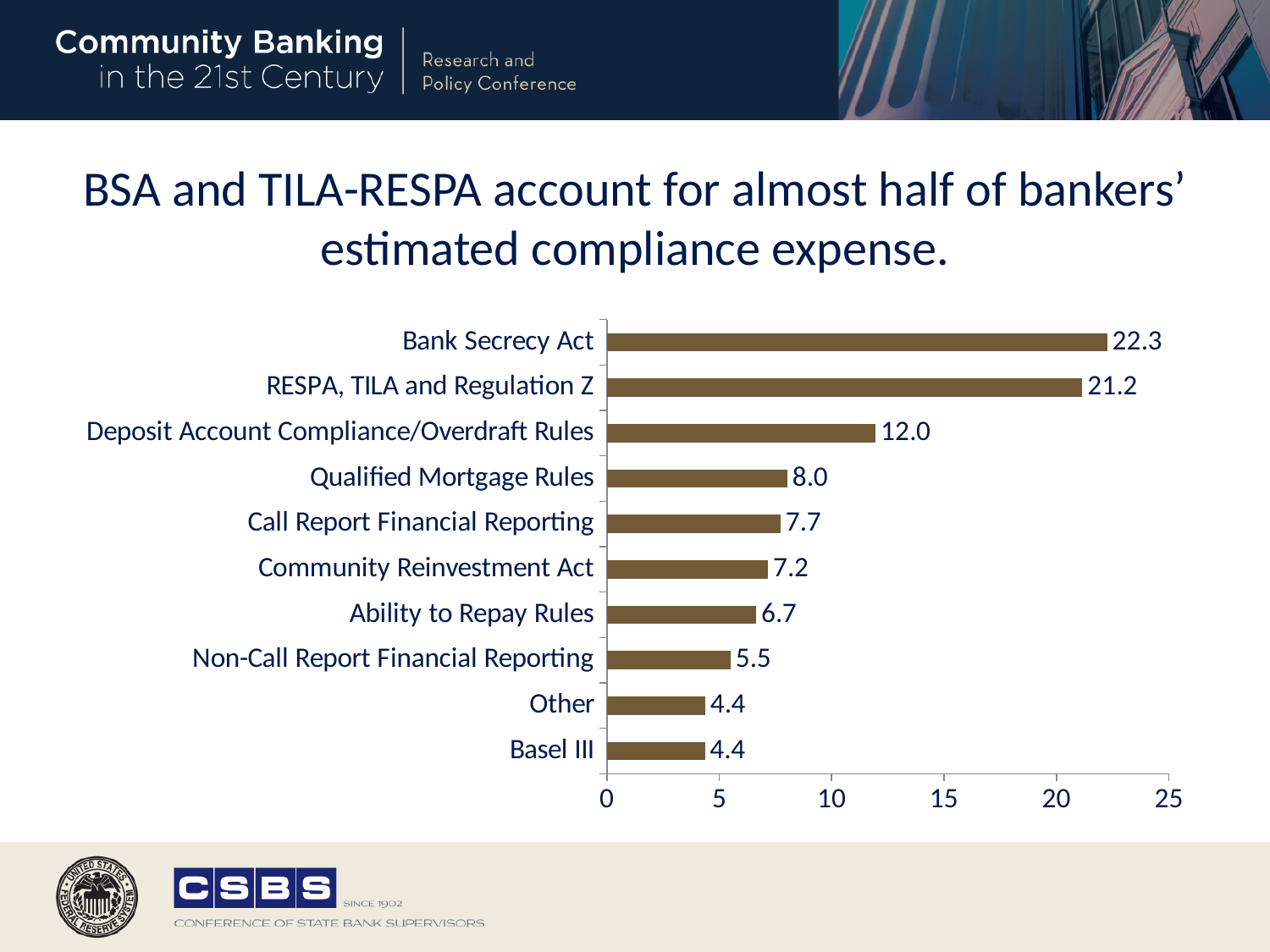
Is the value for Deposit Account Compliance/Overdraft Rules greater or less than 10? greater What is the difference between the values for Bank Secrecy Act and RESPA, TILA and Regulation Z? 1.1 What is the maximum value shown on the horizontal axis? 25 What is the total of the values for Other and Basel III? 8.8 Which category has the highest value? Bank Secrecy Act What is the value for Non-Call Report Financial Reporting? 5.5 What is the value for Deposit Account Compliance/Overdraft Rules? 12.0 What is the value for Bank Secrecy Act? 22.3 Which is larger, the value for Qualified Mortgage Rules or the value for Ability to Repay Rules? Qualified Mortgage Rules What is the value for Call Report Financial Reporting? 7.7 What kind of chart is shown on the slide? bar chart How many categories are shown in the chart? 10